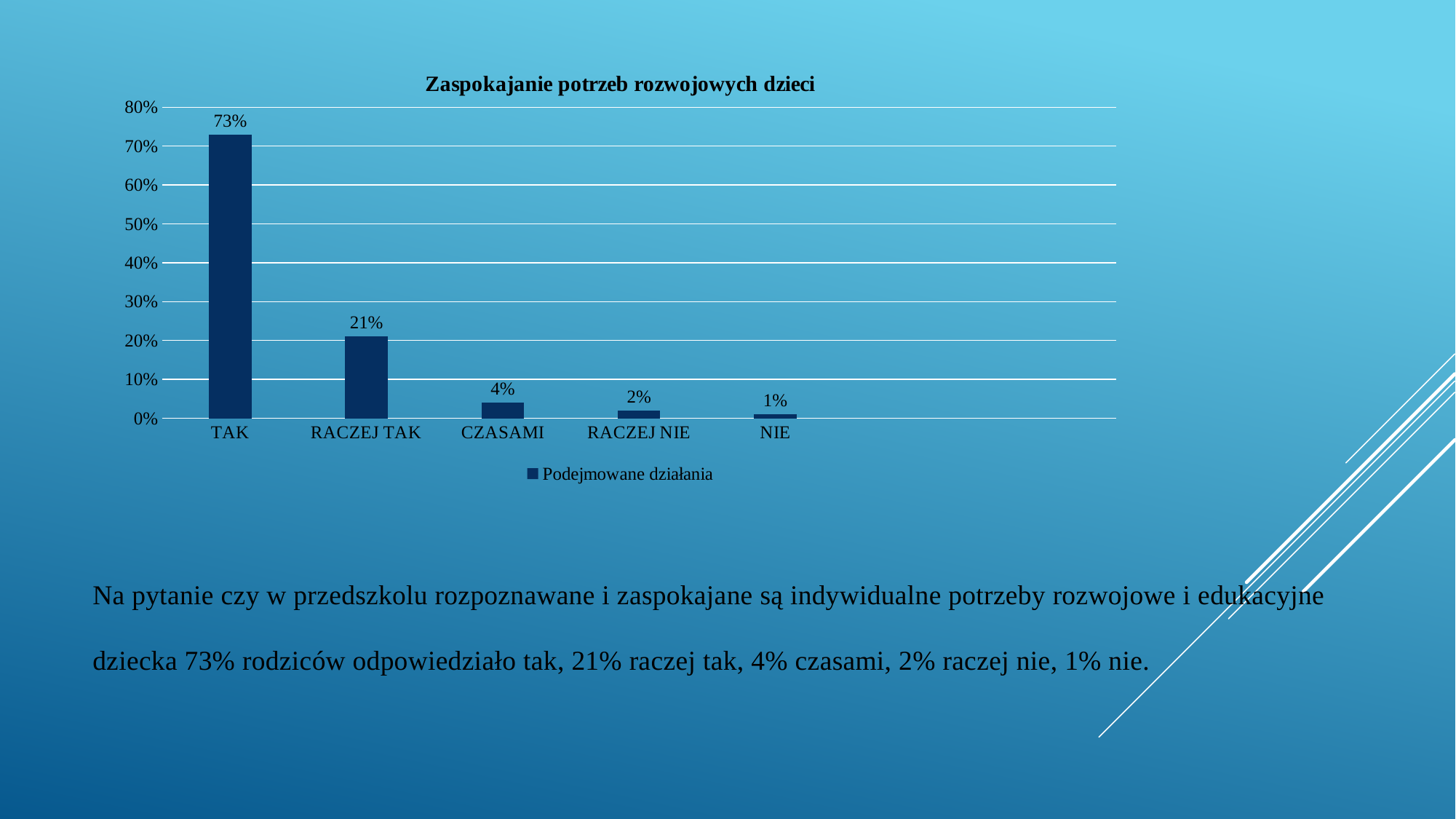
What is the value for TAK? 73% How many categories are shown on the x axis? 5 What is the value for CZASAMI? 4% What is the value for RACZEJ TAK? 21% What is the difference between the values for TAK and RACZEJ TAK? 52% Which is larger, the value for CZASAMI or the value for RACZEJ NIE? CZASAMI Which category has the highest value? TAK Is the value for TAK greater or less than 70%? greater What is the value for NIE? 1% Which category has the lowest value? NIE What is the title of the chart? Zaspokajanie potrzeb rozwojowych dzieci What kind of chart is shown? bar chart